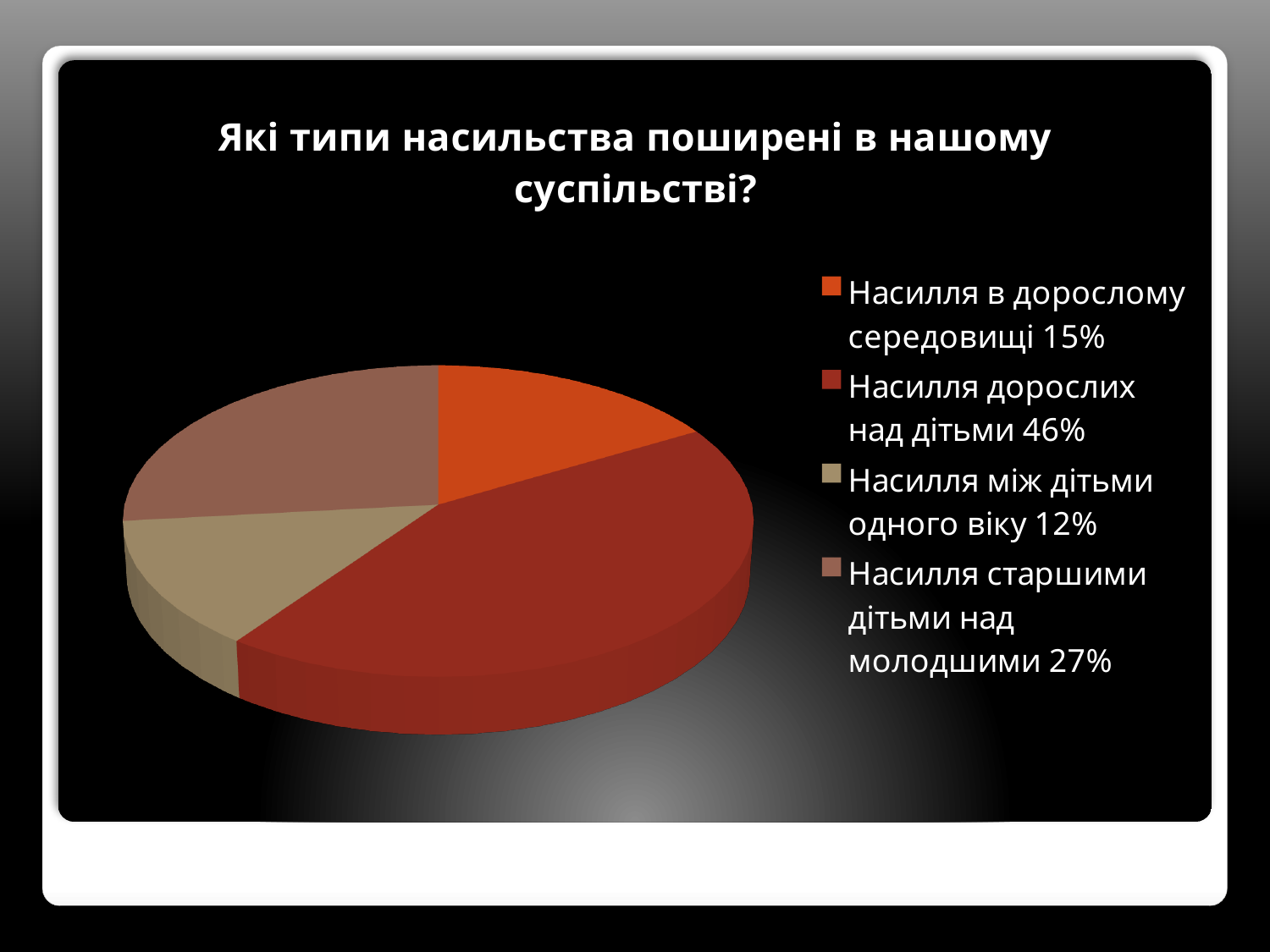
How many slices does the pie chart have? 4 What kind of chart is shown on the slide? pie chart What is the title of the chart? Які типи насильства поширені в нашому суспільстві? What is the difference in percentage points between "Насилля дорослих над дітьми" and "Насилля старшими дітьми над молодшими"? 19 Which is larger: "Насилля в дорослому середовищі" or "Насилля між дітьми одного віку"? Насилля в дорослому середовищі Which category has the smallest slice of the pie? Насилля між дітьми одного віку What share of the pie is "Насилля старшими дітьми над молодшими"? 27% What colour is the slice for "Насилля між дітьми одного віку"? tan (beige) What share of the pie is "Насилля в дорослому середовищі"? 15% Which category has the largest slice of the pie? Насилля дорослих над дітьми What share of the pie is "Насилля між дітьми одного віку"? 12%